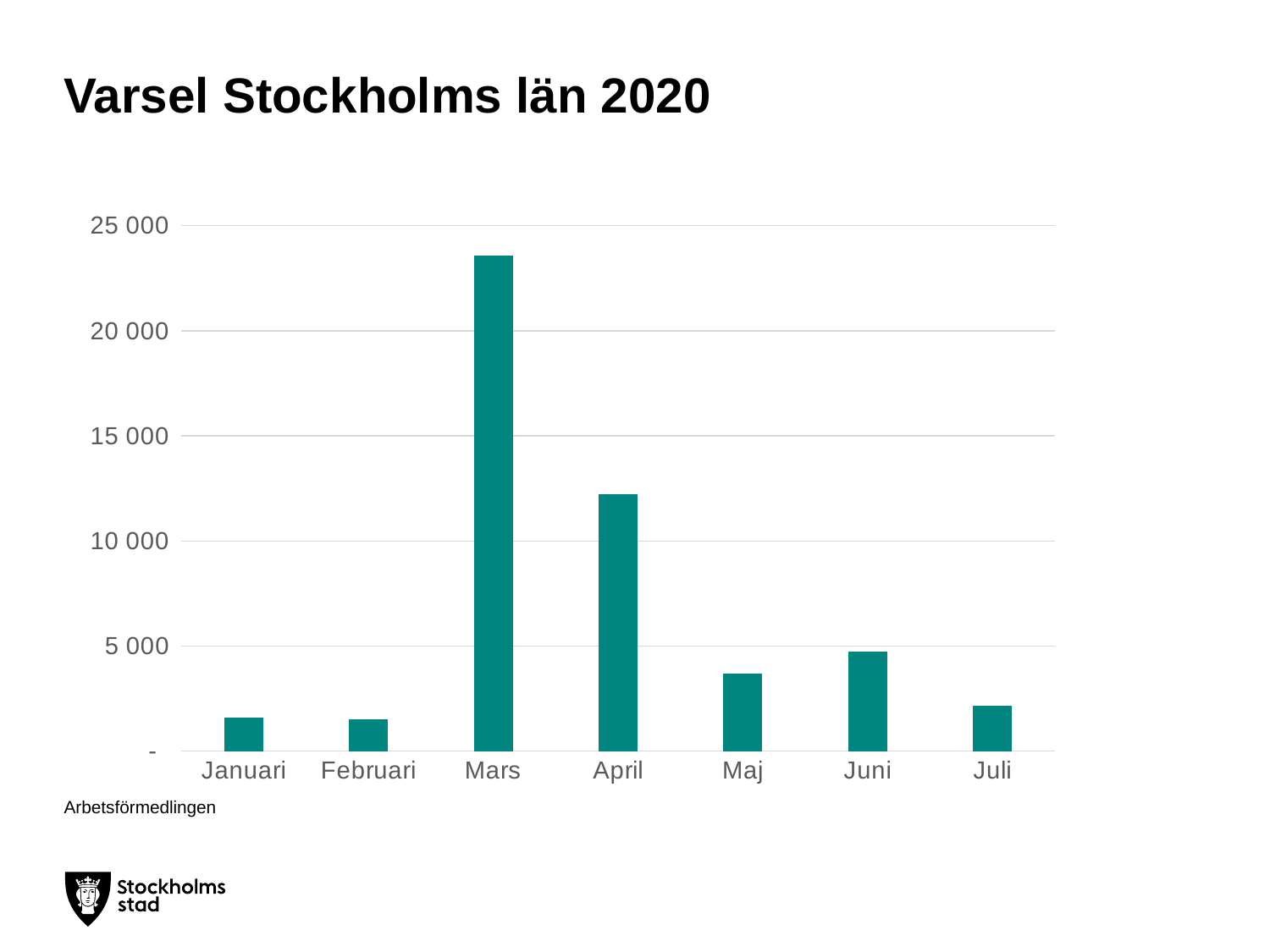
Is the value for Mars greater or less than 20 000? greater Is the value for April greater or less than 10 000? greater What source is cited below the chart? Arbetsförmedlingen Is the value for Maj greater or less than 5 000? less What is the title of the slide? Varsel Stockholms län 2020 What kind of chart is shown on the slide? bar chart Which month has the highest value in the chart? Mars How many months are shown on the x axis of the chart? 7 Which is larger, the value for Juni or the value for Maj? Juni Which is larger, the value for April or the value for Juli? April